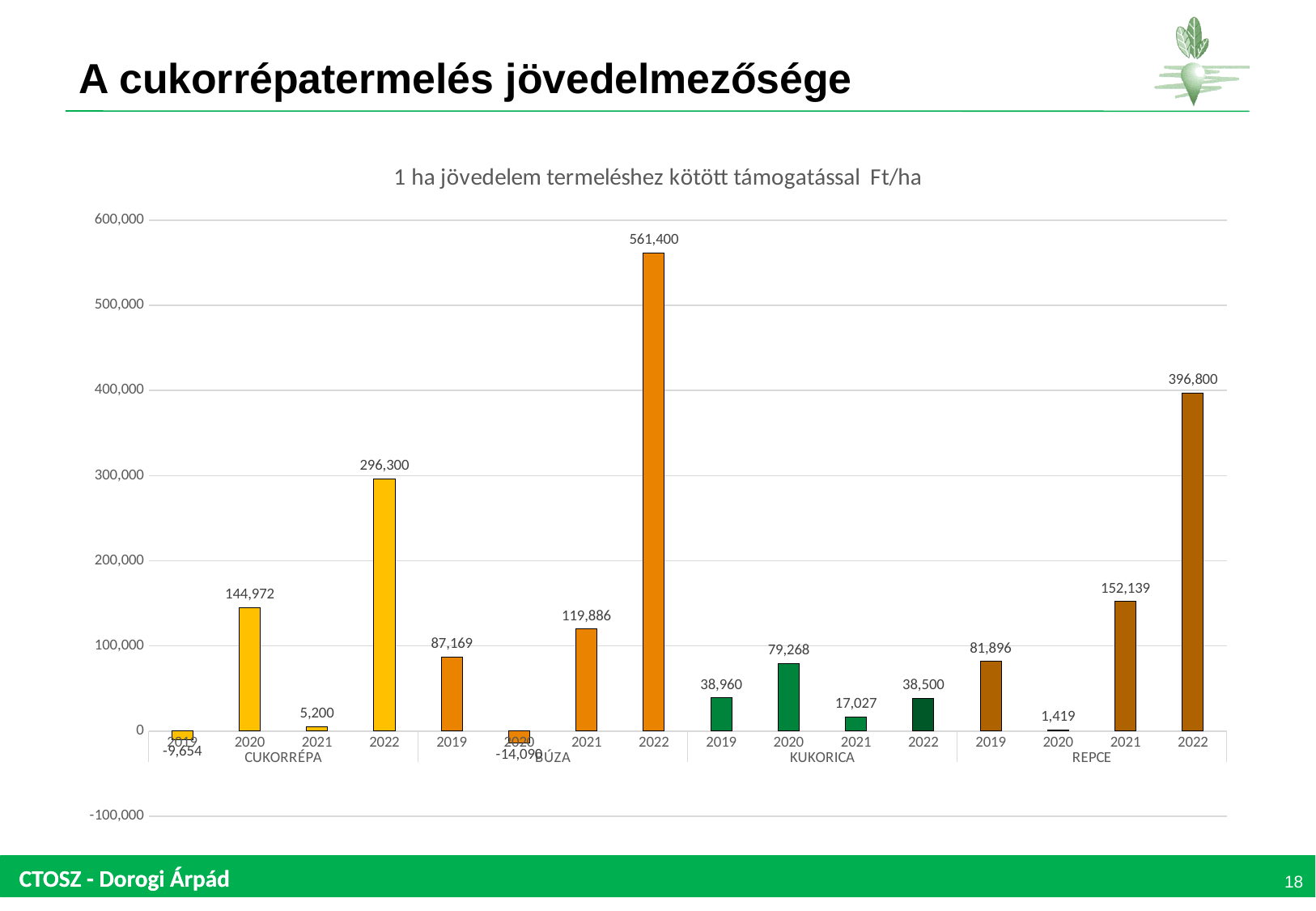
What is the value for BÚZA in 2022? 561,400 What is the value for CUKORRÉPA in 2019? -9,654 How many bars are plotted in the chart? 16 Which bar has the highest value in the chart? BÚZA 2022 What is the difference between the REPCE 2022 value and the REPCE 2021 value? 244,661 Is the value for REPCE in 2022 greater or less than 300,000? greater What is the value for KUKORICA in 2021? 17,027 Which is larger, the CUKORRÉPA 2020 value or the BÚZA 2021 value? CUKORRÉPA 2020 What type of chart is shown on the slide? bar chart What is the value for CUKORRÉPA in 2022? 296,300 What is the value for REPCE in 2020? 1,419 Which year has the lowest value within the KUKORICA group? 2021